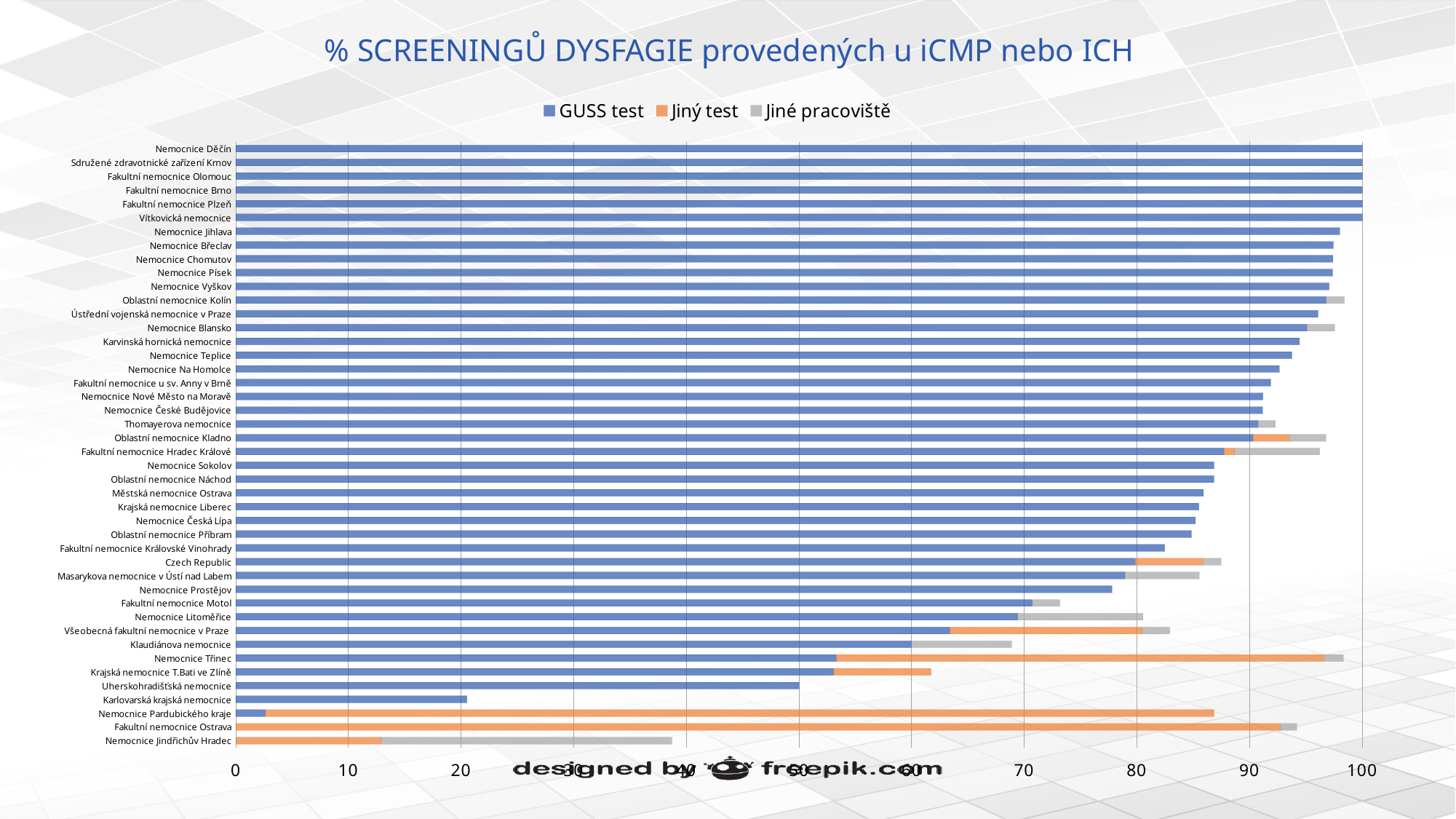
What kind of chart is shown on the slide? bar chart Is the GUSS test value for Nemocnice Prostějov greater or less than 80? less Is the GUSS test value for Všeobecná fakultní nemocnice v Praze greater or less than 60? greater What is the GUSS test value for Nemocnice Děčín? 100 Which series is shown in orange in the legend? Jiný test What is the title of the chart? % SCREENINGŮ DYSFAGIE provedených u iCMP nebo ICH How many hospitals (categories) are listed on the chart? 44 Is the GUSS test value for Nemocnice Pardubického kraje greater or less than 10? less How many series does the legend list? 3 Which hospital has the largest Jiný test value? Fakultní nemocnice Ostrava What is the GUSS test value for Fakultní nemocnice Brno? 100 Which has the larger GUSS test value, Nemocnice Třinec or Karlovarská krajská nemocnice? Nemocnice Třinec